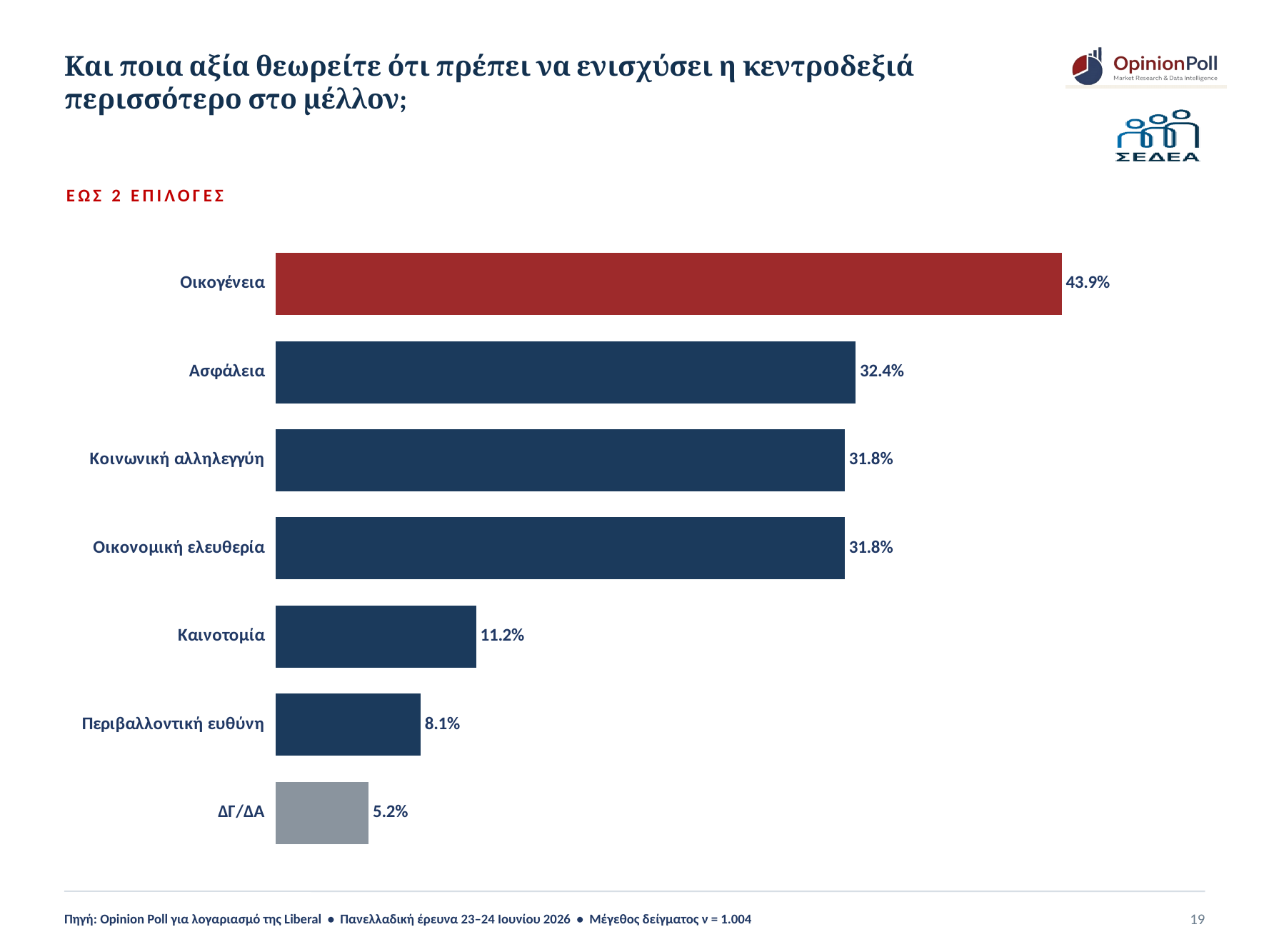
What is the value for ΔΓ/ΔΑ? 5.2% What is the value for Καινοτομία? 11.2% Which is larger, the value for Κοινωνική αλληλεγγύη or the value for Καινοτομία? Κοινωνική αλληλεγγύη What kind of chart is shown on the slide? Bar chart How many categories are shown in the chart? 7 What is the difference between the values for Οικογένεια and Ασφάλεια? 11.5% What is the value for Περιβαλλοντική ευθύνη? 8.1% What is the difference between the values for Καινοτομία and Περιβαλλοντική ευθύνη? 3.1% What is the value for Οικογένεια? 43.9% Which category has the lowest value? ΔΓ/ΔΑ Which category has the highest value? Οικογένεια What is the value for Ασφάλεια? 32.4%